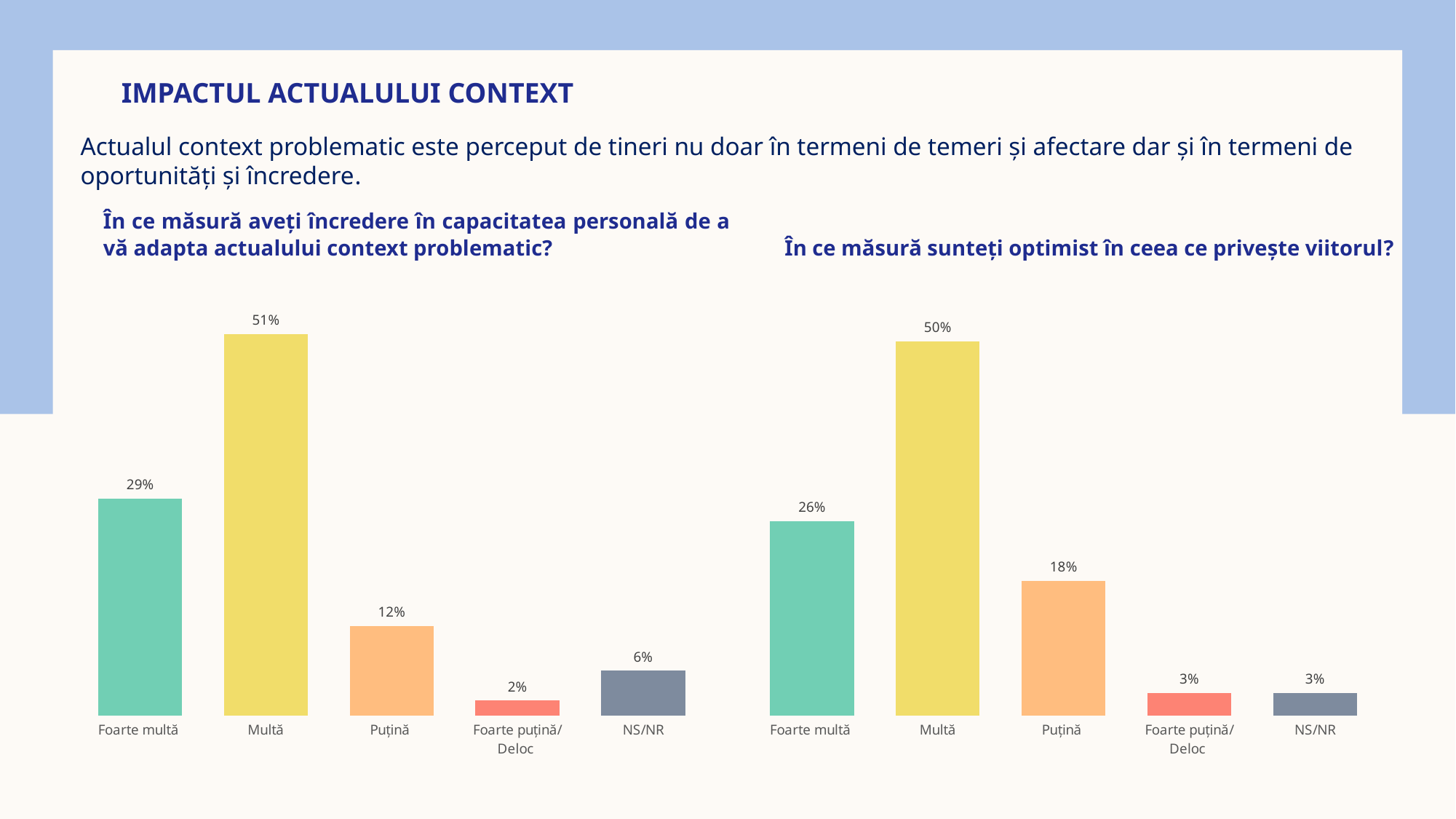
In the right chart (În ce măsură sunteți optimist...), what is the difference between Foarte multă and Puțină? 8% Which is larger: Puțină in the left chart (În ce măsură aveți încredere...) or Puțină in the right chart (În ce măsură sunteți optimist...)? Puțină in the right chart In the left chart (În ce măsură aveți încredere în capacitatea personală de a vă adapta actualului context problematic?), what is the value for Multă? 51% In the left chart (În ce măsură aveți încredere...), what is the value for Foarte multă? 29% In the right chart (În ce măsură sunteți optimist...), what is the value for NS/NR? 3% How many categories does the right chart (În ce măsură sunteți optimist...) show? 5 In the right chart (În ce măsură sunteți optimist...), which category has the highest value? Multă In the right chart (În ce măsură sunteți optimist în ceea ce privește viitorul?), what is the value for Puțină? 18% In the left chart (În ce măsură aveți încredere...), which category has the highest value? Multă What kind of chart is the left chart (În ce măsură aveți încredere...)? Bar chart In the left chart (În ce măsură aveți încredere...), what is the difference between Multă and Foarte multă? 22% In the left chart (În ce măsură aveți încredere...), which category has the lowest value? Foarte puțină/Deloc